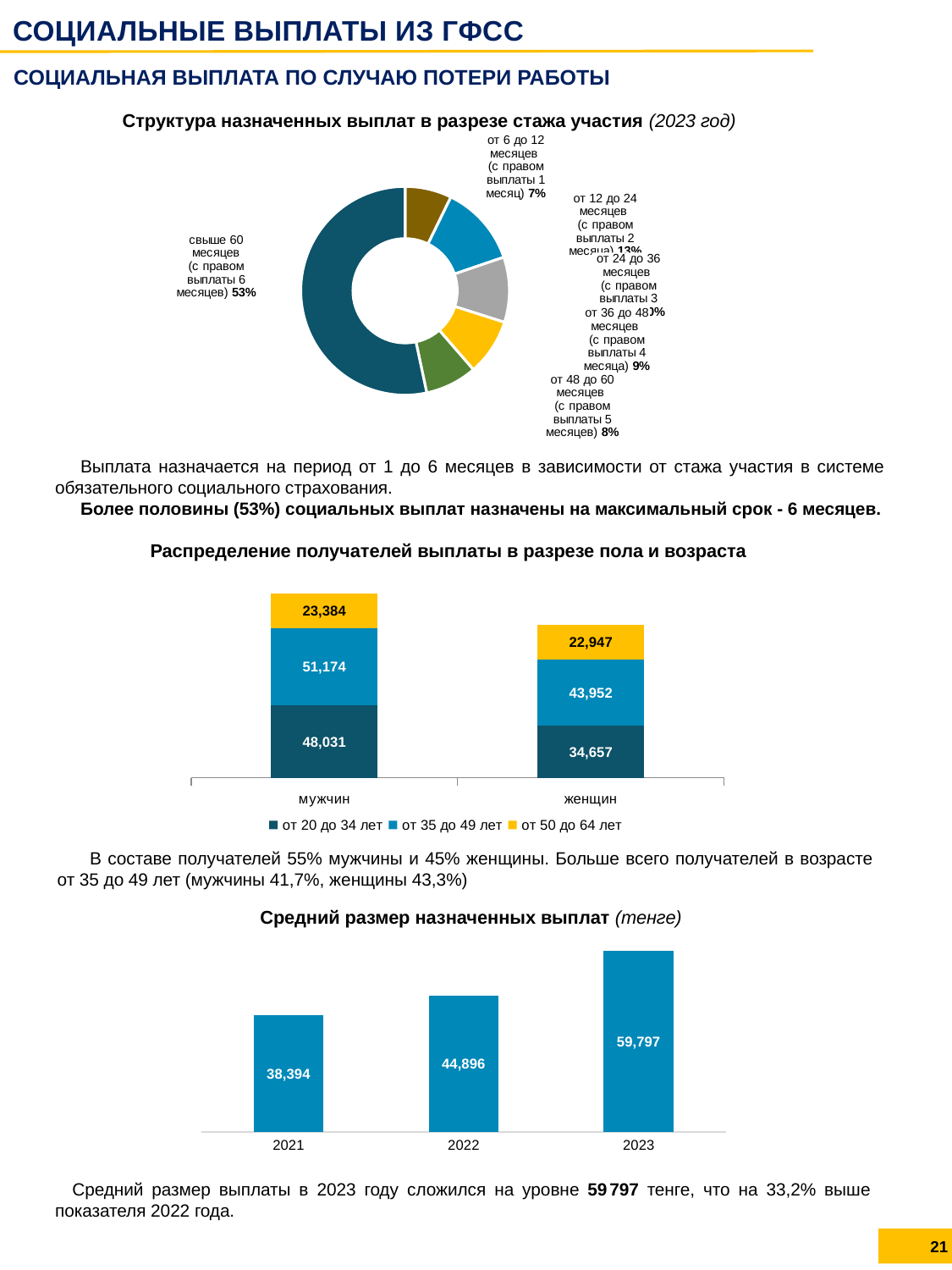
In the chart 'Структура назначенных выплат в разрезе стажа участия', what share is for 'от 6 до 12 месяцев'? 7% In the chart 'Средний размер назначенных выплат', what is the difference between 2023 and 2022? 14,901 In the chart 'Распределение получателей выплаты в разрезе пола и возраста', how many series does the legend list? 3 In the chart 'Структура назначенных выплат в разрезе стажа участия', what share of payments is for 'свыше 60 месяцев'? 53% In the chart 'Средний размер назначенных выплат', what is the value for 2023? 59,797 In the chart 'Средний размер назначенных выплат', do the values rise or fall from 2021 to 2023? Rise In the chart 'Распределение получателей выплаты в разрезе пола и возраста', what is the value for 'от 50 до 64 лет' among 'женщин'? 22,947 In the chart 'Распределение получателей выплаты в разрезе пола и возраста', what is the difference between 'от 20 до 34 лет' for 'мужчин' and for 'женщин'? 13,374 In the chart 'Распределение получателей выплаты в разрезе пола и возраста', what is the value for 'от 35 до 49 лет' among 'мужчин'? 51,174 In the chart 'Распределение получателей выплаты в разрезе пола и возраста', what is the total of the stacked bar for 'мужчин'? 122,589 In the chart 'Структура назначенных выплат в разрезе стажа участия', which tenure category has the largest share? свыше 60 месяцев What kind of chart is 'Структура назначенных выплат в разрезе стажа участия'? Donut (pie) chart